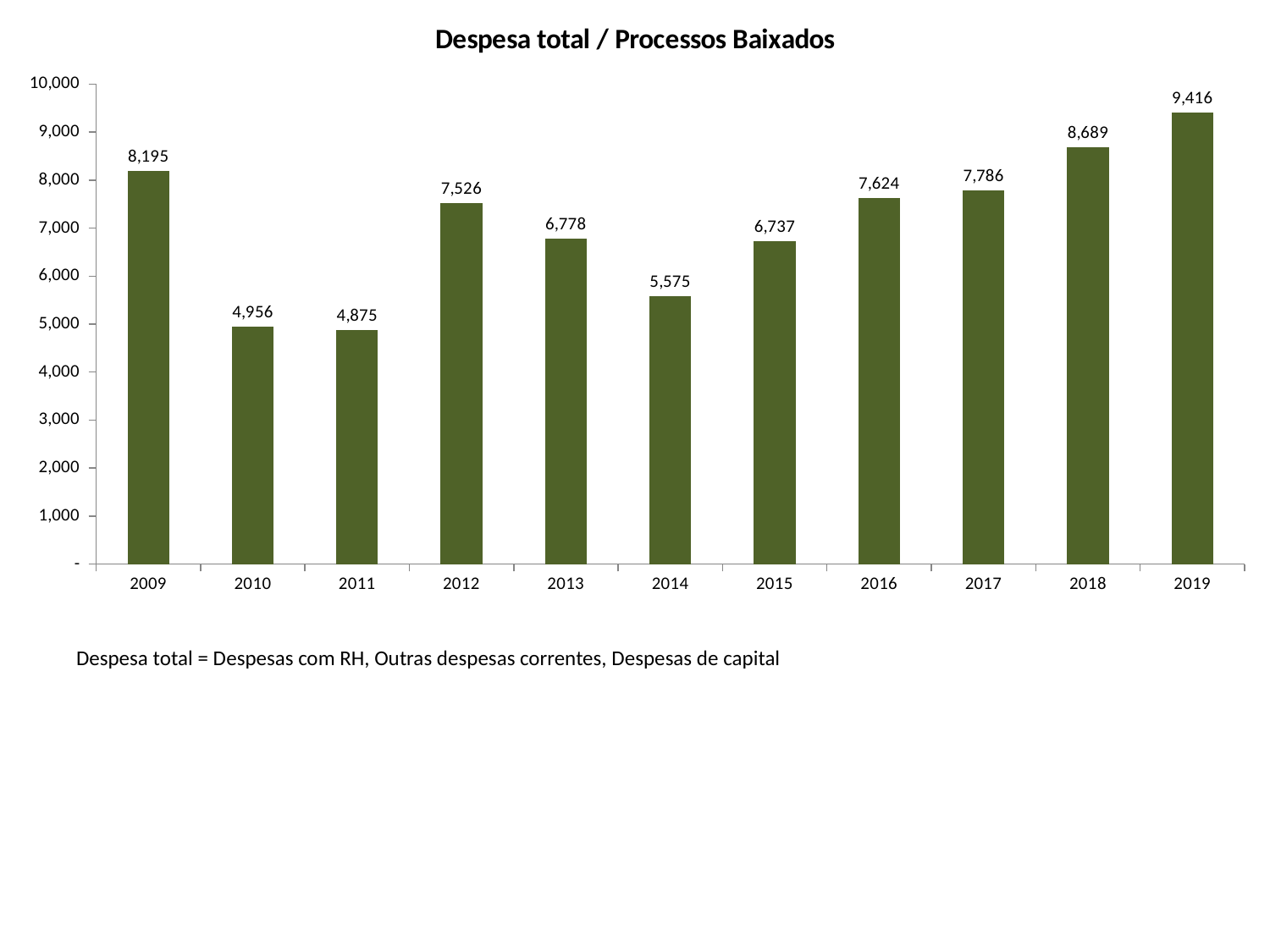
What is the difference between the values for 2019 and 2018? 727 What is the title of the chart? Despesa total / Processos Baixados How many years are shown on the x axis? 11 Which year has the highest value? 2019 What is the difference between the values for 2012 and 2013? 748 What is the value for 2014? 5,575 What is the value for 2009? 8,195 Is the value for 2010 greater or less than 5,000? less What is the value for 2017? 7,786 What kind of chart is this? bar chart Which is larger, the value for 2015 or the value for 2016? 2016 Which year has the lowest value? 2011